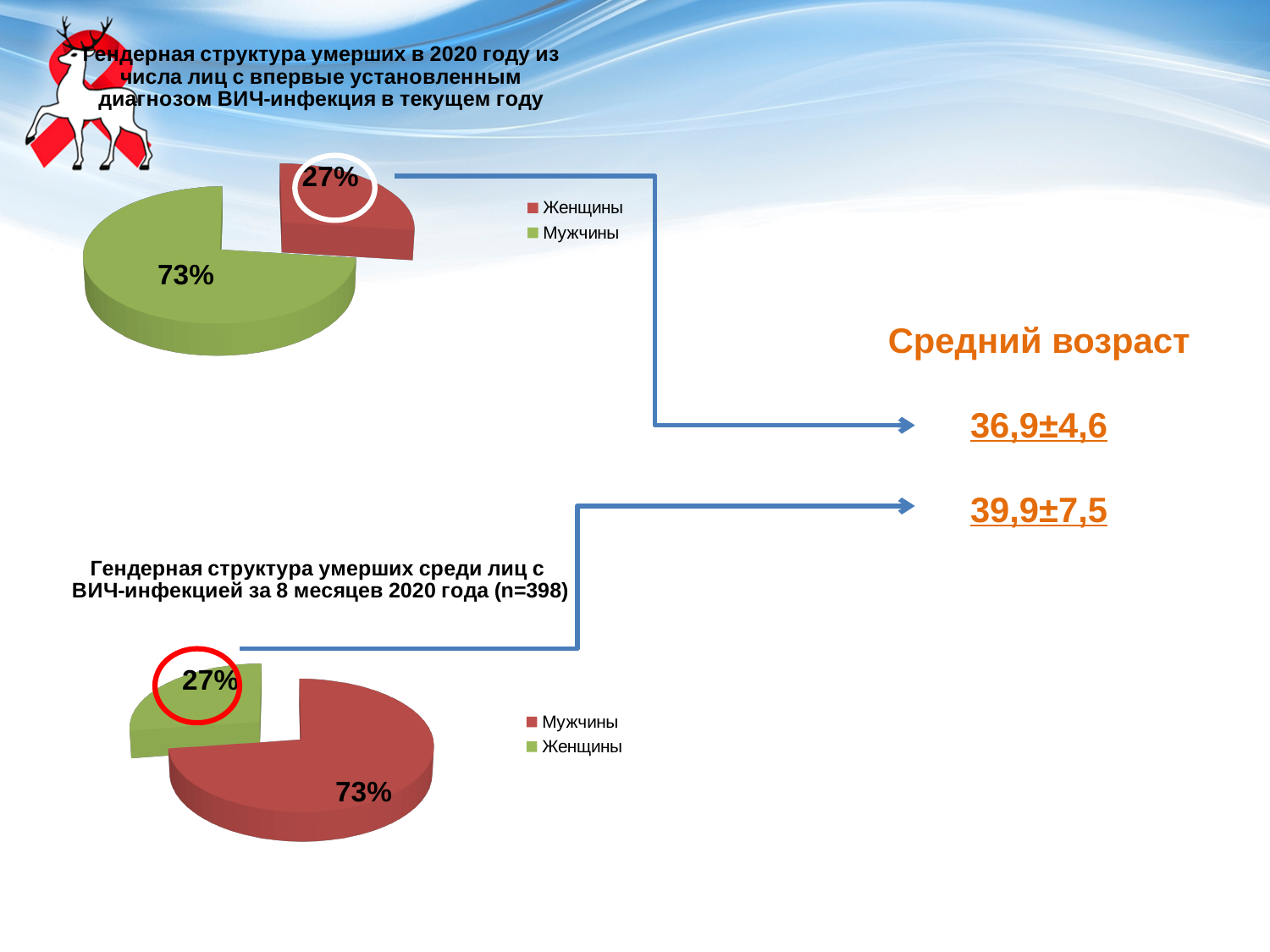
How many categories does the legend of the bottom pie chart list? 2 In the bottom pie chart, which category has the smallest slice? Женщины In the bottom pie chart, which is larger: the share for Мужчины or the share for Женщины? Мужчины In the bottom pie chart (deaths among persons with HIV over 8 months of 2020, n=398), what share is labelled for Женщины? 27% In the top pie chart (deaths in 2020 among persons newly diagnosed with HIV), what share is labelled for Мужчины? 73% In the top pie chart, which category has the largest slice? Мужчины In the top pie chart, what colour is the slice for Мужчины? Green In the bottom pie chart (deaths among persons with HIV over 8 months of 2020, n=398), what share is labelled for Мужчины? 73% In the bottom pie chart, what colour is the slice for Мужчины? Red In the top pie chart, what is the difference in percentage points between Мужчины and Женщины? 46 In the top pie chart (deaths in 2020 among persons newly diagnosed with HIV), what share is labelled for Женщины? 27% What type of chart is the top chart on the slide? Pie chart